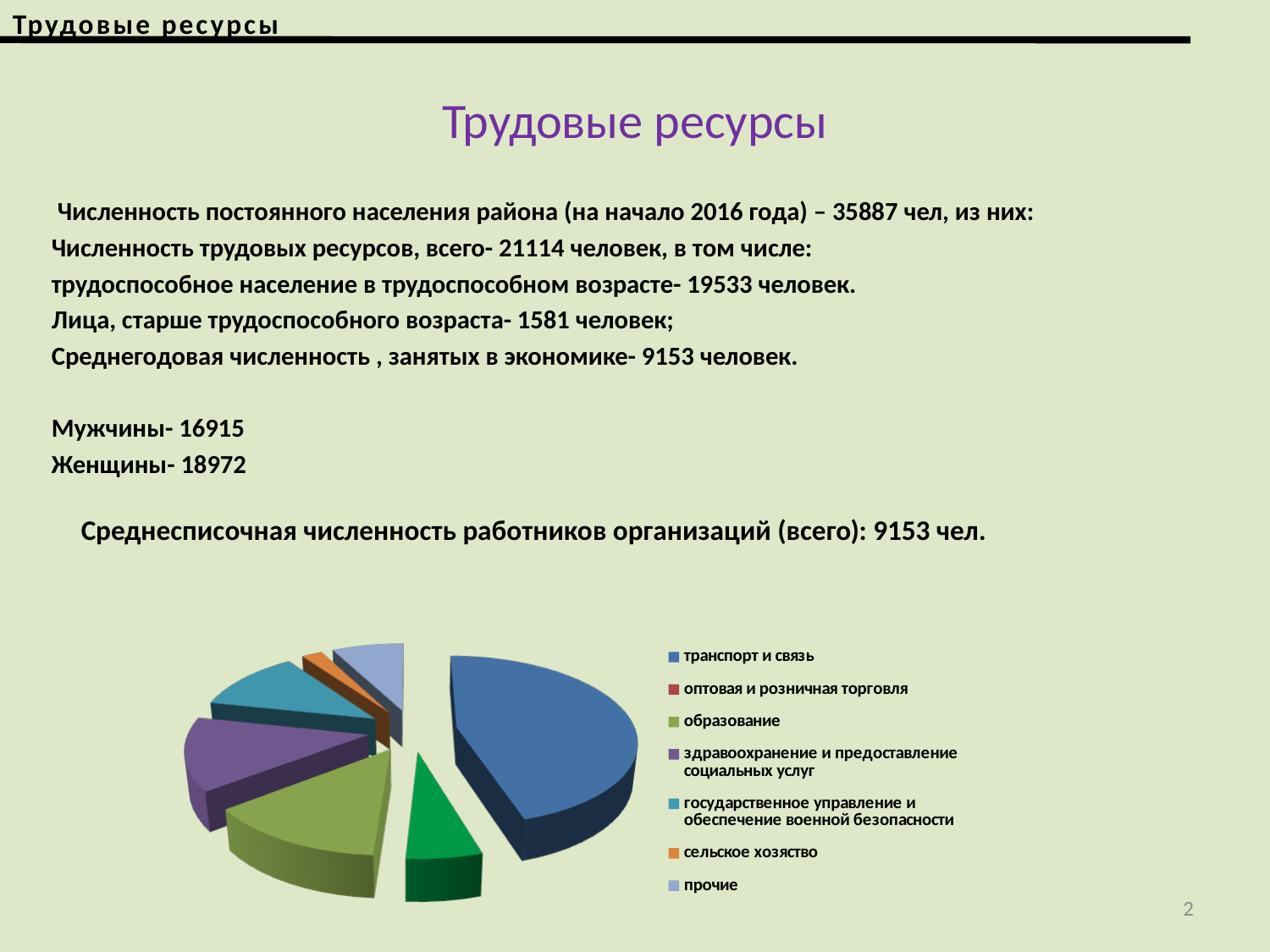
What colour is the slice for сельское хозяйство in the pie chart? orange Which category has the smallest slice of the pie chart? сельское хозяйство What kind of chart is shown on the slide? pie chart Which slice is larger: образование or сельское хозяйство? образование Which slice is larger: оптовая и розничная торговля or транспорт и связь? транспорт и связь Which slice is larger: транспорт и связь or образование? транспорт и связь Which category has the largest slice of the pie chart? транспорт и связь What colour is the slice for транспорт и связь in the pie chart? blue How many categories does the pie chart's legend list? 7